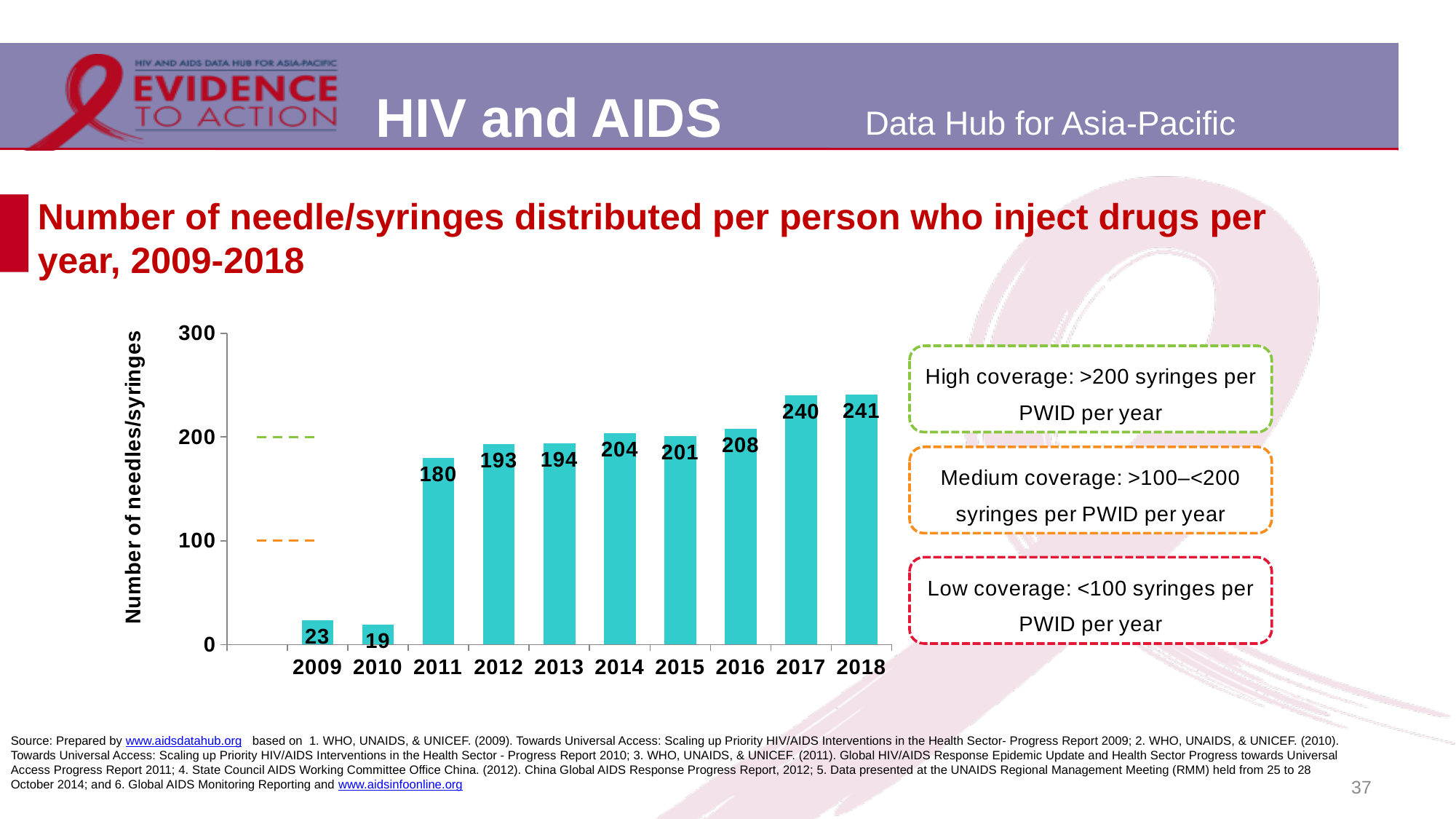
What is the difference between the values for 2017 and 2016? 32 Which year has the lowest number of needles/syringes distributed per person? 2010 What is the difference between the values for 2018 and 2009? 218 What kind of chart is shown on the slide? Bar chart Which year has the highest number of needles/syringes distributed per person? 2018 Which year has a larger value, 2012 or 2015? 2015 Is the value for 2014 greater or less than 200? greater What is the value shown for 2016? 208 What is the value shown for 2010? 19 How many years are shown on the x axis of the chart? 10 What is the label of the y axis of the chart? Number of needles/syringes What is the number of needles/syringes distributed per person who injects drugs in 2011? 180